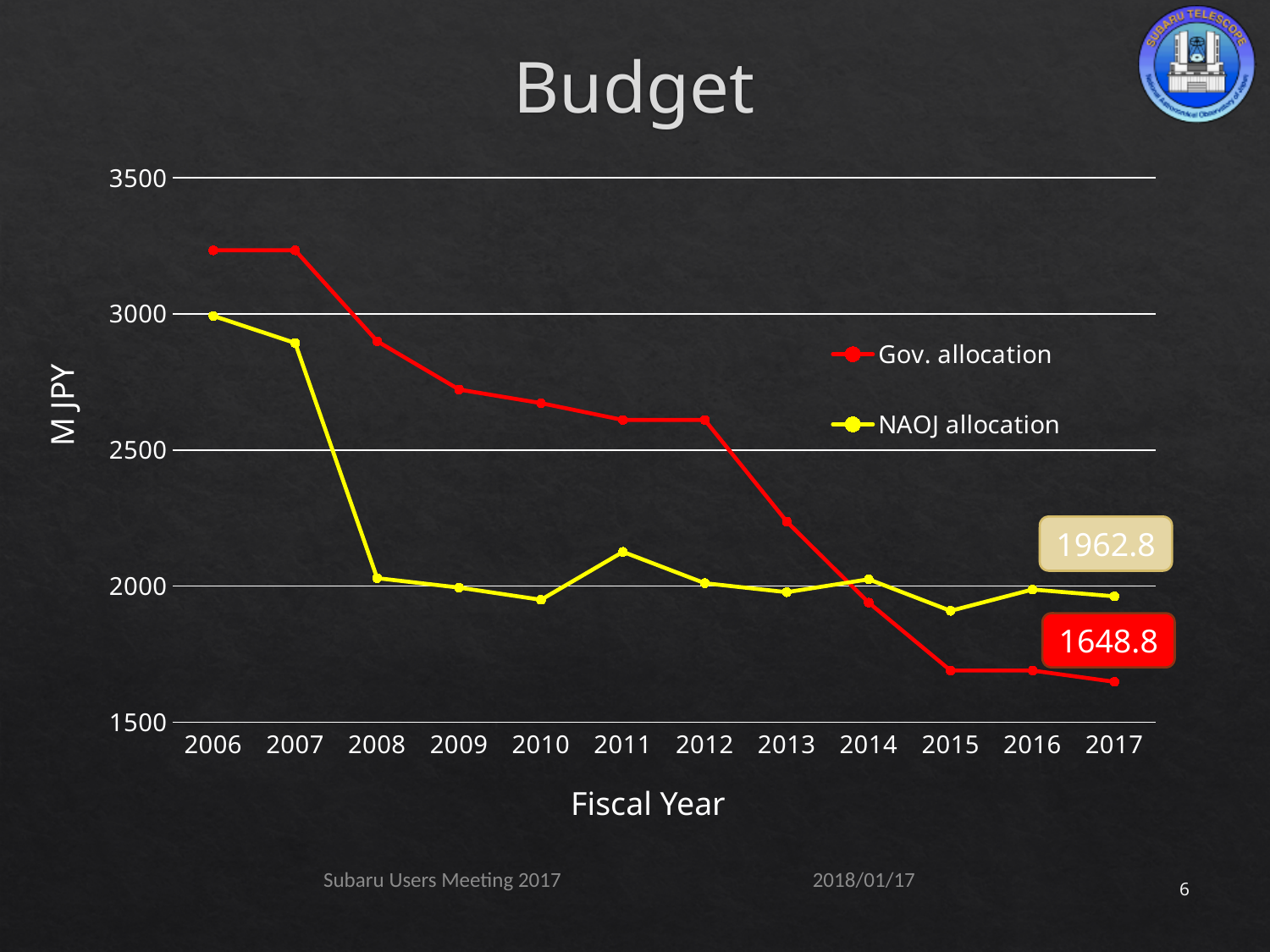
In fiscal year 2006, which is larger, the Gov. allocation or the NAOJ allocation? Gov. allocation What is the label on the y axis of the chart? M JPY Is the Gov. allocation for 2006 greater or less than 3000? greater What is the NAOJ allocation value labelled for fiscal year 2017? 1962.8 What is the Gov. allocation value labelled for fiscal year 2017? 1648.8 How many series does the legend list? 2 How many fiscal years are plotted along the x axis? 12 What is the difference between the NAOJ allocation and the Gov. allocation in fiscal year 2017? 314.0 Is the Gov. allocation for 2015 greater or less than 2000? less What type of chart is shown on the slide? line chart Does the Gov. allocation generally rise or fall from 2006 to 2017? fall In fiscal year 2017, which is larger, the Gov. allocation or the NAOJ allocation? NAOJ allocation